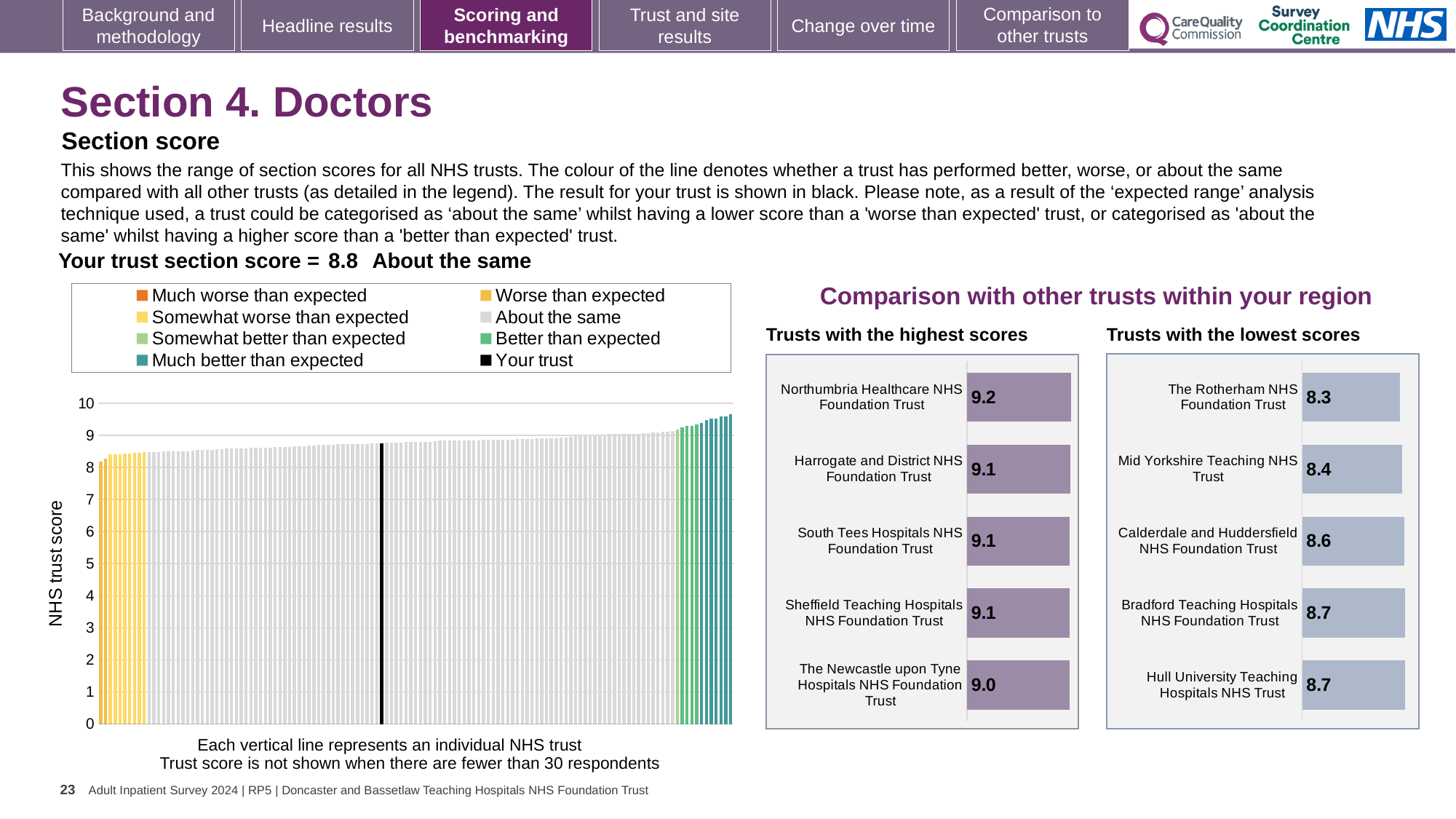
In the 'Trusts with the lowest scores' chart, which trust has the lowest score? The Rotherham NHS Foundation Trust How many trusts are listed in the 'Trusts with the lowest scores' chart? 5 In the 'Trusts with the highest scores' chart, what is the difference between the scores of Northumbria Healthcare NHS Foundation Trust and The Newcastle upon Tyne Hospitals NHS Foundation Trust? 0.2 In the NHS trust score chart on the left, is the value for the black 'Your trust' bar greater or less than 9? less In the 'Trusts with the highest scores' chart, which trust has the highest score? Northumbria Healthcare NHS Foundation Trust In the 'Trusts with the highest scores' chart, what is the score for Northumbria Healthcare NHS Foundation Trust? 9.2 How many entries does the legend of the NHS trust score chart on the left list? 8 What kind of chart is the NHS trust score chart on the left? bar chart In the 'Trusts with the lowest scores' chart, which has the larger score: Mid Yorkshire Teaching NHS Trust or Bradford Teaching Hospitals NHS Foundation Trust? Bradford Teaching Hospitals NHS Foundation Trust In the 'Trusts with the lowest scores' chart, what is the score for The Rotherham NHS Foundation Trust? 8.3 In the 'Trusts with the lowest scores' chart, what is the difference between the scores of Calderdale and Huddersfield NHS Foundation Trust and The Rotherham NHS Foundation Trust? 0.3 In the 'Trusts with the highest scores' chart, what is the score for The Newcastle upon Tyne Hospitals NHS Foundation Trust? 9.0